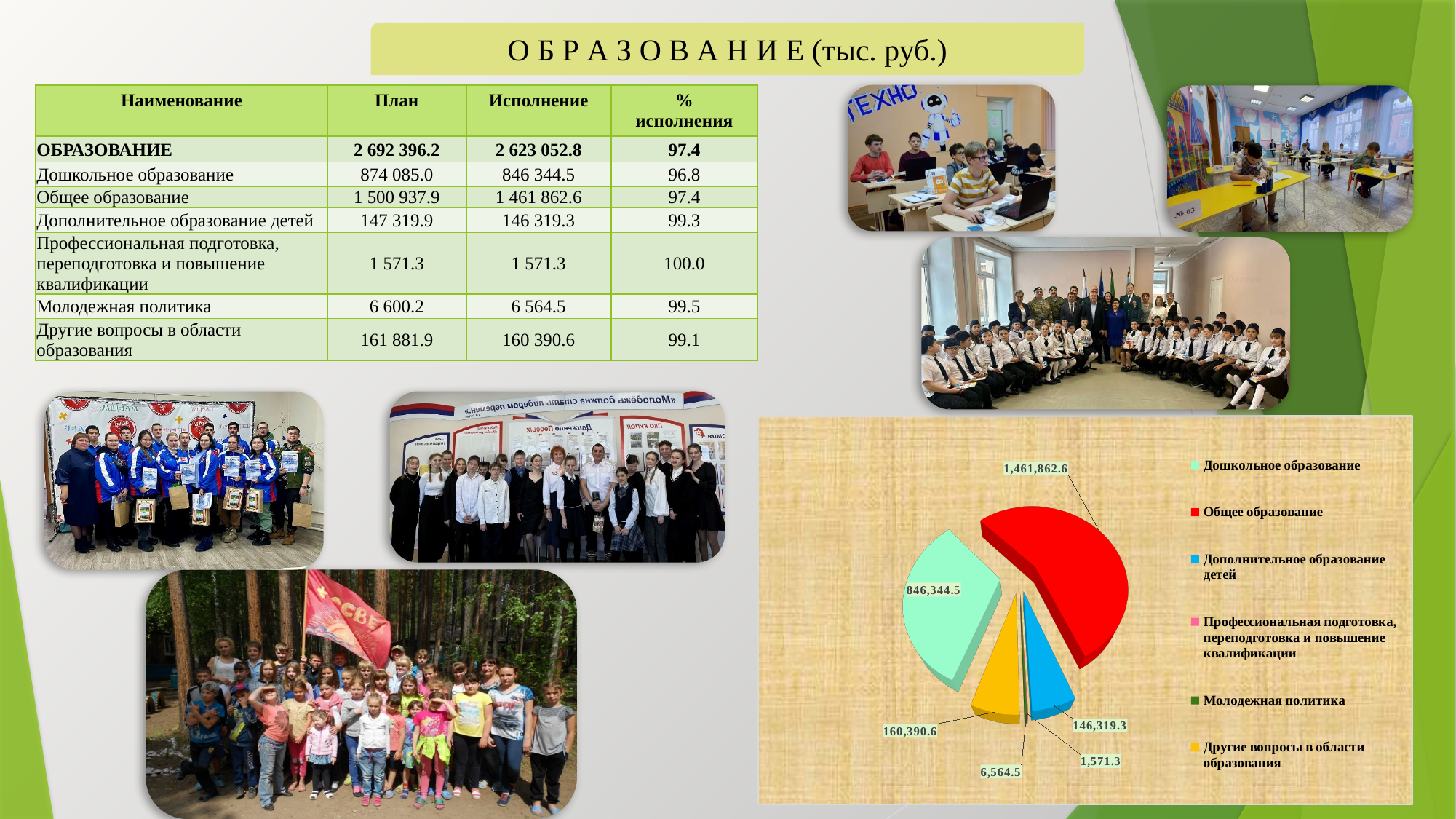
Which is larger in the pie chart: Дополнительное образование детей or Другие вопросы в области образования? Другие вопросы в области образования What is the value of the Молодежная политика slice in the pie chart? 6,564.5 What kind of chart is shown on the slide? Pie chart How many slices does the pie chart have? 6 What is the difference between the Общее образование and Дошкольное образование values in the pie chart? 615,518.1 How many entries does the legend of the pie chart list? 6 Which category has the smallest slice in the pie chart? Профессиональная подготовка, переподготовка и повышение квалификации Which category has the largest slice in the pie chart? Общее образование What is the value of the Общее образование slice in the pie chart? 1,461,862.6 What is the value of the Дошкольное образование slice in the pie chart? 846,344.5 What colour is the Общее образование slice in the pie chart? Red What is the value of the Другие вопросы в области образования slice in the pie chart? 160,390.6